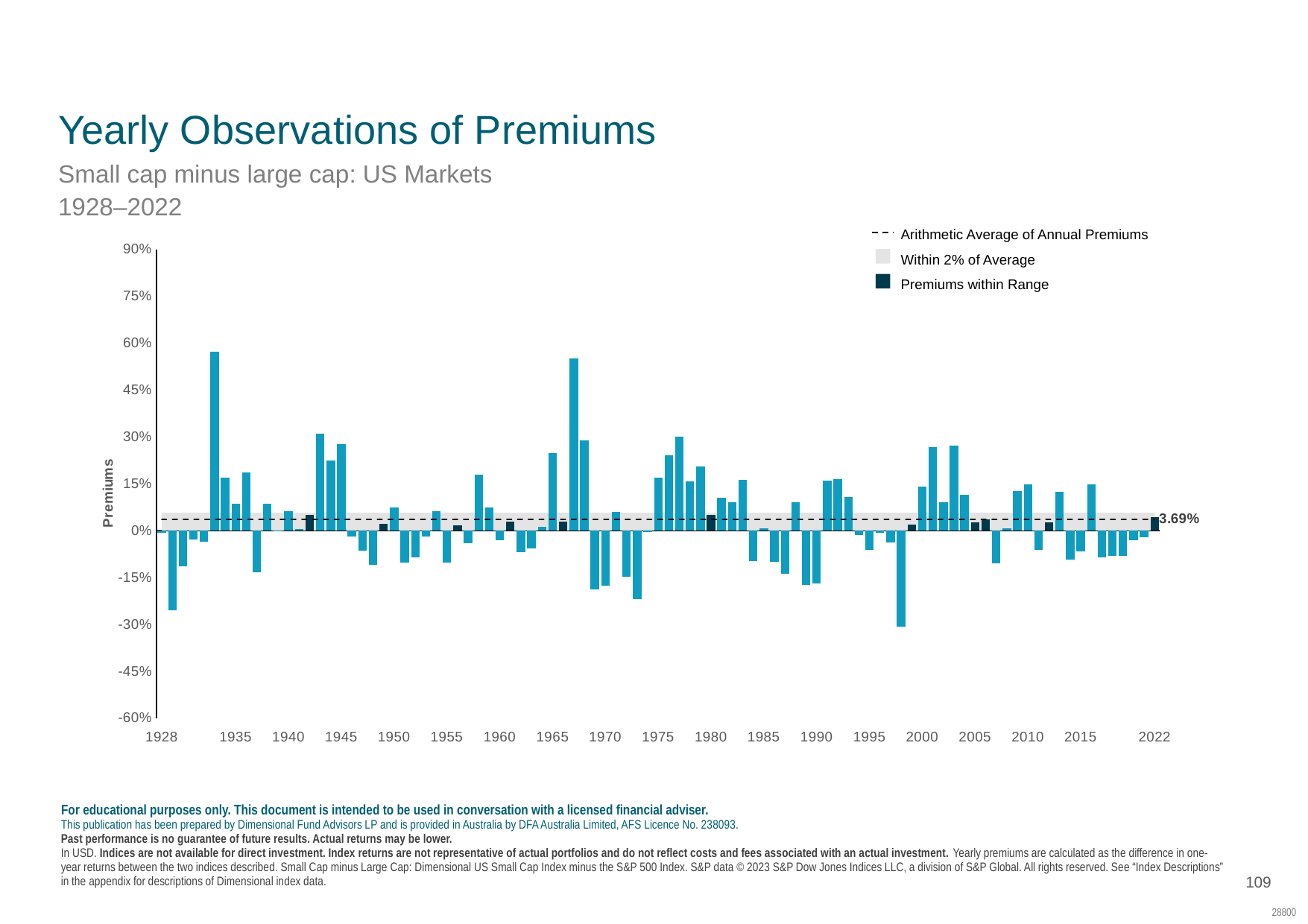
What kind of chart is shown on the slide? bar chart Which year has the larger premium, 1945 or 1970? 1945 Is the premium for 1990 greater or less than 0%? less What is the label on the vertical axis of the chart? Premiums Is the premium for 2015 greater or less than 0%? less Is the premium for 2010 greater or less than 0%? greater What is the arithmetic average of annual premiums shown on the chart? 3.69% How many entries does the chart legend list? 3 Which year has the larger premium, 1945 or 2010? 1945 What does the dashed horizontal line on the chart represent, according to the legend? Arithmetic Average of Annual Premiums